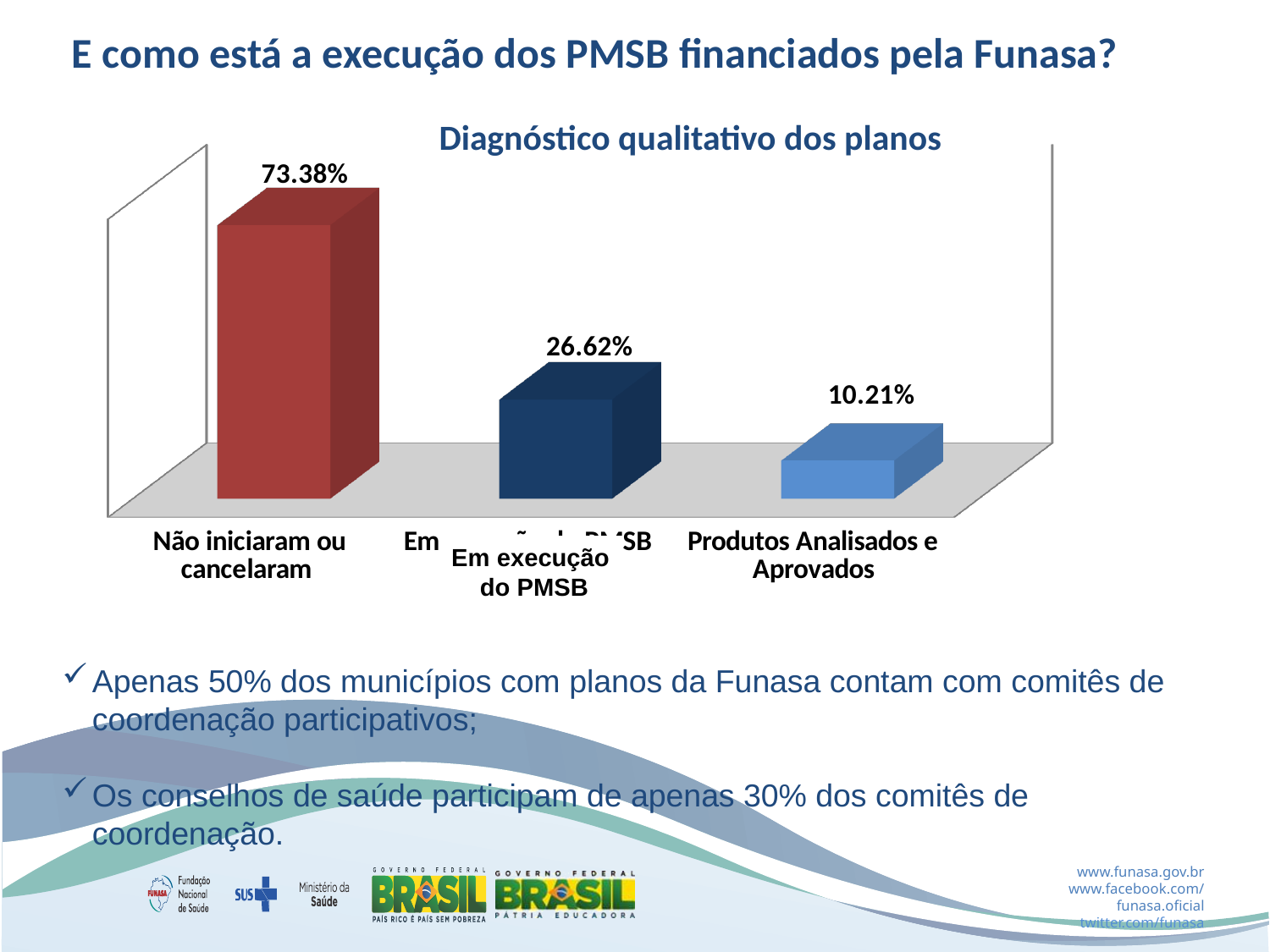
What is the value for "Produtos Analisados e Aprovados" in the chart? 10.21% Which category has the lowest value in the chart? Produtos Analisados e Aprovados Which is larger: the value for "Em execução do PMSB" or the value for "Produtos Analisados e Aprovados"? Em execução do PMSB What is the difference between the values for "Em execução do PMSB" and "Produtos Analisados e Aprovados"? 16.41% What is the difference between the values for "Não iniciaram ou cancelaram" and "Em execução do PMSB"? 46.76% Which category has the highest value in the chart? Não iniciaram ou cancelaram What is the title of the chart? Diagnóstico qualitativo dos planos Do the values rise or fall from left to right across the categories? Fall How many categories are shown in the chart? 3 What is the value for "Não iniciaram ou cancelaram" in the chart? 73.38% What kind of chart is shown on the slide? Bar chart What is the value for "Em execução do PMSB" in the chart? 26.62%